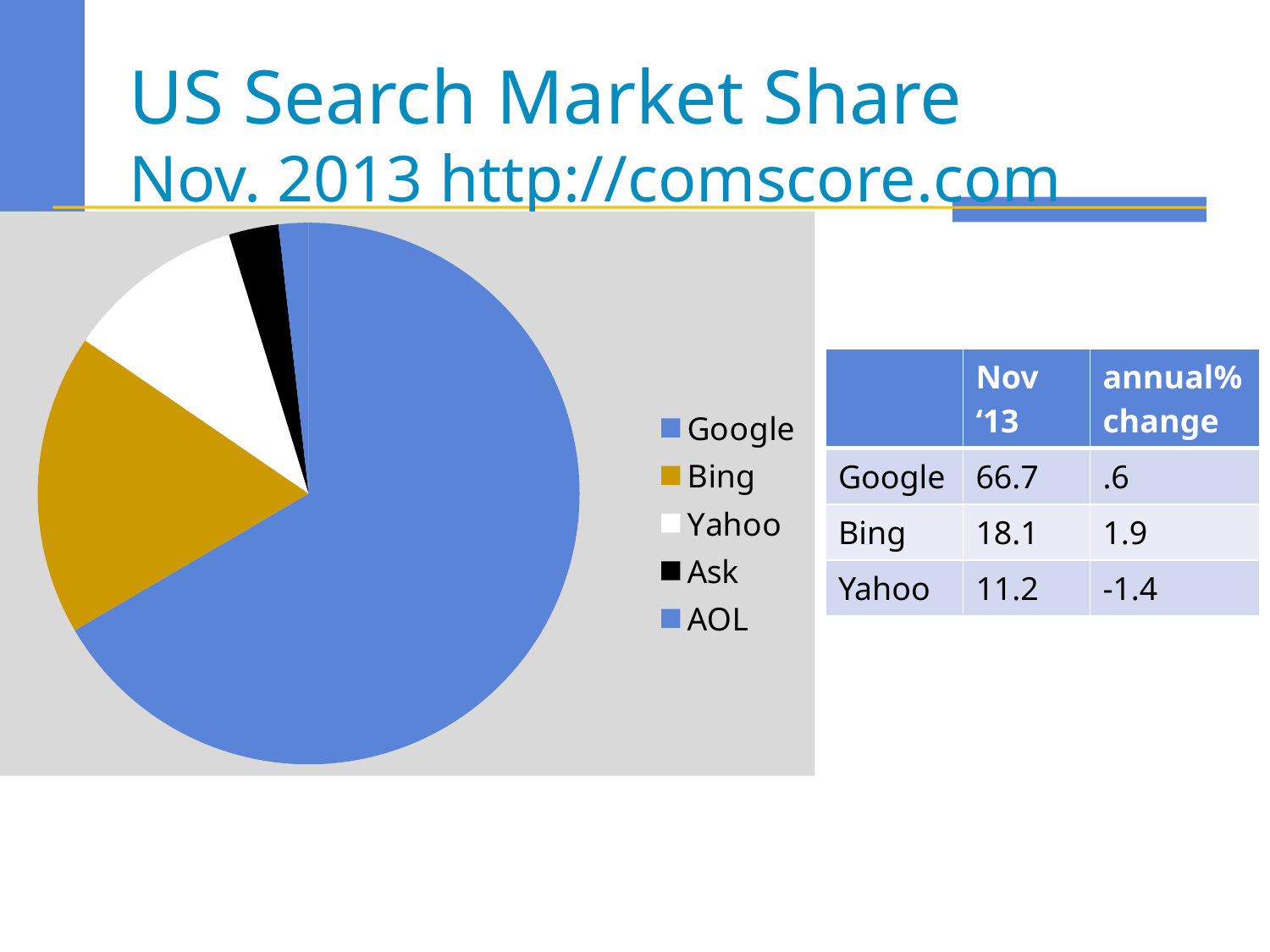
Using the table on the slide, what is the difference between Bing's and Yahoo's Nov '13 values? 6.9 How many categories does the pie chart's legend list? 5 Which category has the smallest slice in the pie chart? AOL Which slice is larger in the pie chart, Yahoo or Ask? Yahoo According to the table on the slide, what is Bing's Nov '13 value? 18.1 What colour is the Bing slice in the pie chart? gold According to the table on the slide, what is Yahoo's annual % change? -1.4 According to the table on the slide, what is Yahoo's Nov '13 value? 11.2 Which category has the largest slice in the pie chart? Google According to the table on the slide, what is Google's Nov '13 value? 66.7 Which slice is larger in the pie chart, Bing or Yahoo? Bing What kind of chart is shown on the slide? pie chart